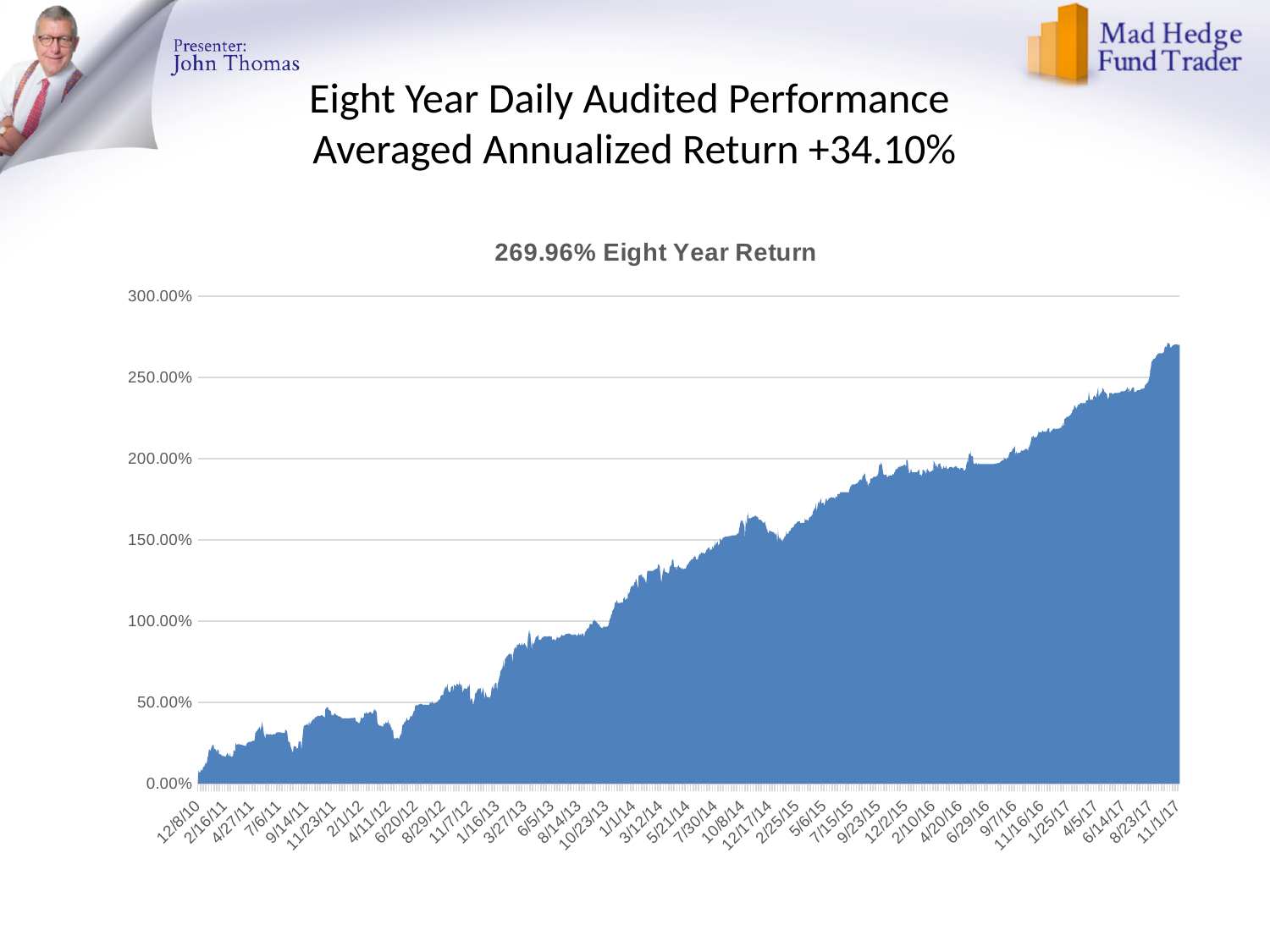
Is the value at 1/25/17 greater or less than 200%? greater What is the highest value shown on the y axis? 300.00% Is the value at 4/27/11 greater or less than 50%? less Is the value at 5/6/15 greater or less than 150%? greater What kind of chart is shown on the slide? area chart Do the values generally rise or fall from left to right along the x axis? rise What is the title of the chart? 269.96% Eight Year Return Which date has the higher value, 7/6/11 or 6/14/17? 6/14/17